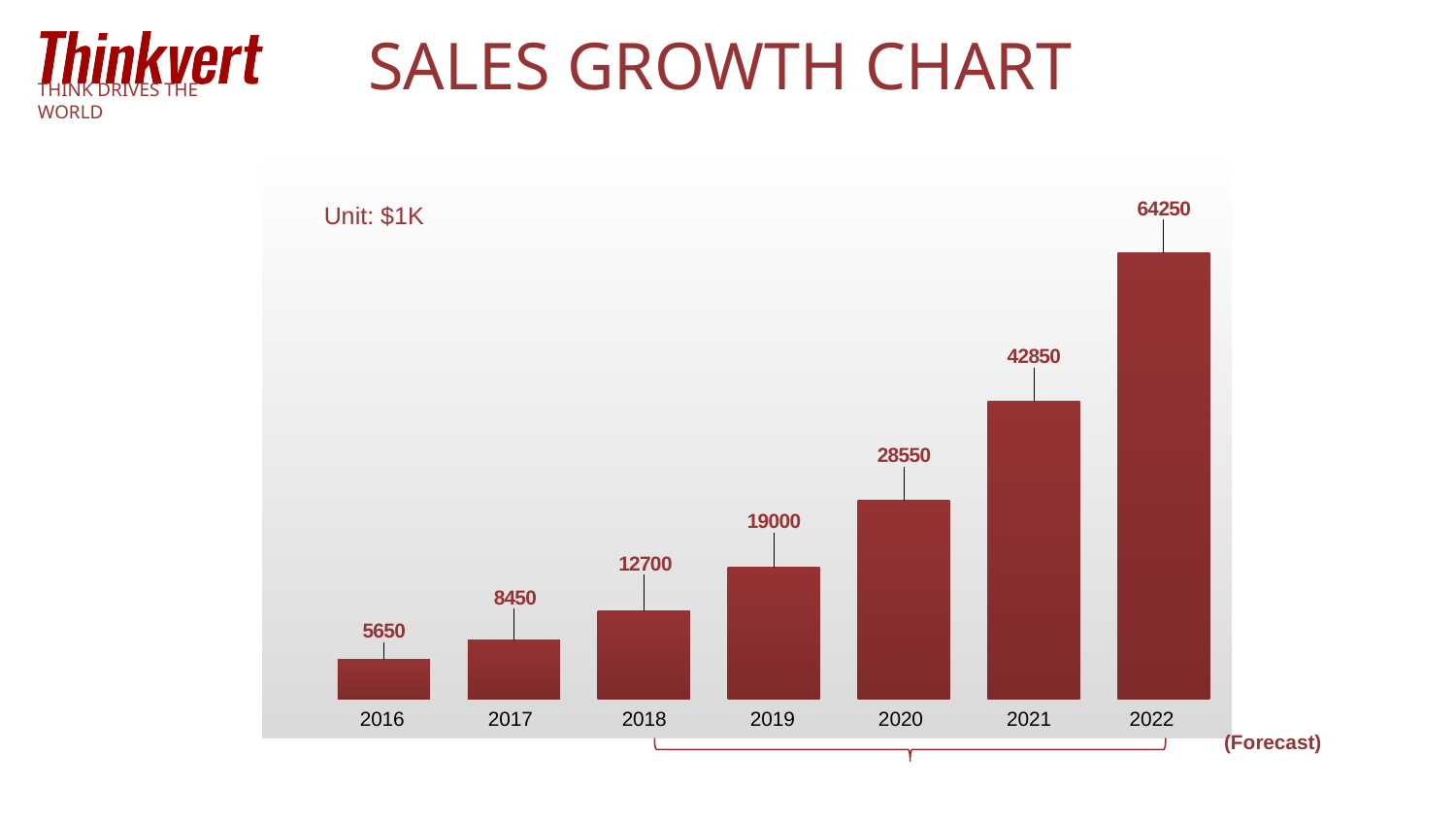
Which year has the lowest value? 2016 Do the values rise or fall from 2016 to 2022? Rise How many years are shown on the chart? 7 What is the difference between the values for 2022 and 2021? 21400 What is the value for 2016? 5650 Which year has the highest value? 2022 What unit is stated for the values on the chart? $1K What kind of chart is shown on the slide? Bar chart Which is larger, the value for 2020 or the value for 2019? 2020 What is the value for 2022? 64250 What is the value for 2019? 19000 What is the difference between the values for 2018 and 2017? 4250